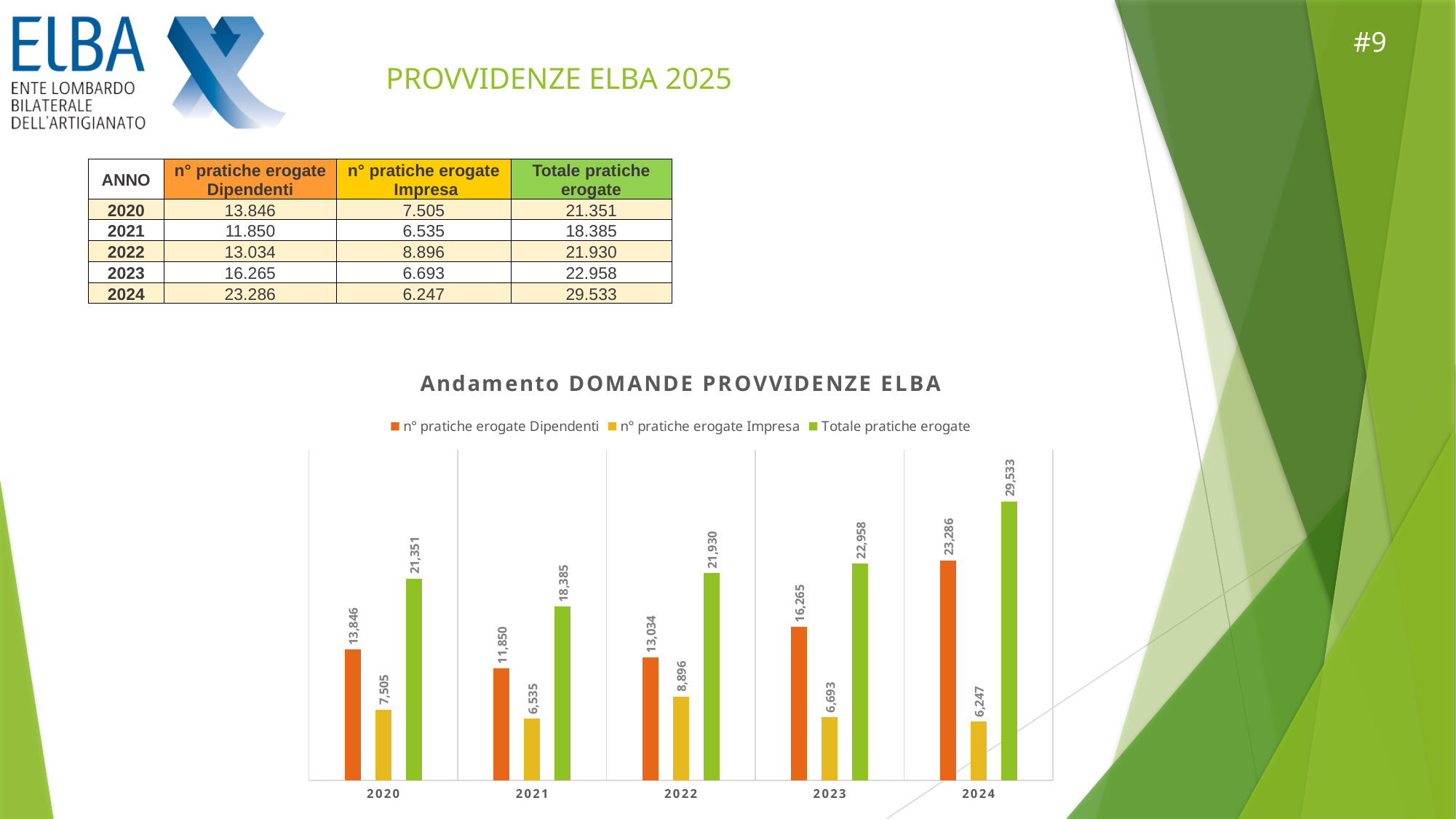
In which year is 'n° pratiche erogate Impresa' lowest? 2024 Which is larger: 'n° pratiche erogate Impresa' in 2020 or in 2021? 2020 What is the title of the chart? Andamento DOMANDE PROVVIDENZE ELBA Does 'Totale pratiche erogate' rise or fall from 2021 to 2024? rise What is the value of 'n° pratiche erogate Impresa' for 2022 in the chart? 8,896 What is the value of 'n° pratiche erogate Dipendenti' for 2024 in the chart? 23,286 In which year is 'Totale pratiche erogate' highest? 2024 What is the difference between 'n° pratiche erogate Dipendenti' in 2024 and in 2023? 7,021 How many years are shown on the x axis of the chart? 5 What type of chart is shown on the slide? bar chart How many series does the chart legend list? 3 What is the value of 'Totale pratiche erogate' for 2021 in the chart? 18,385